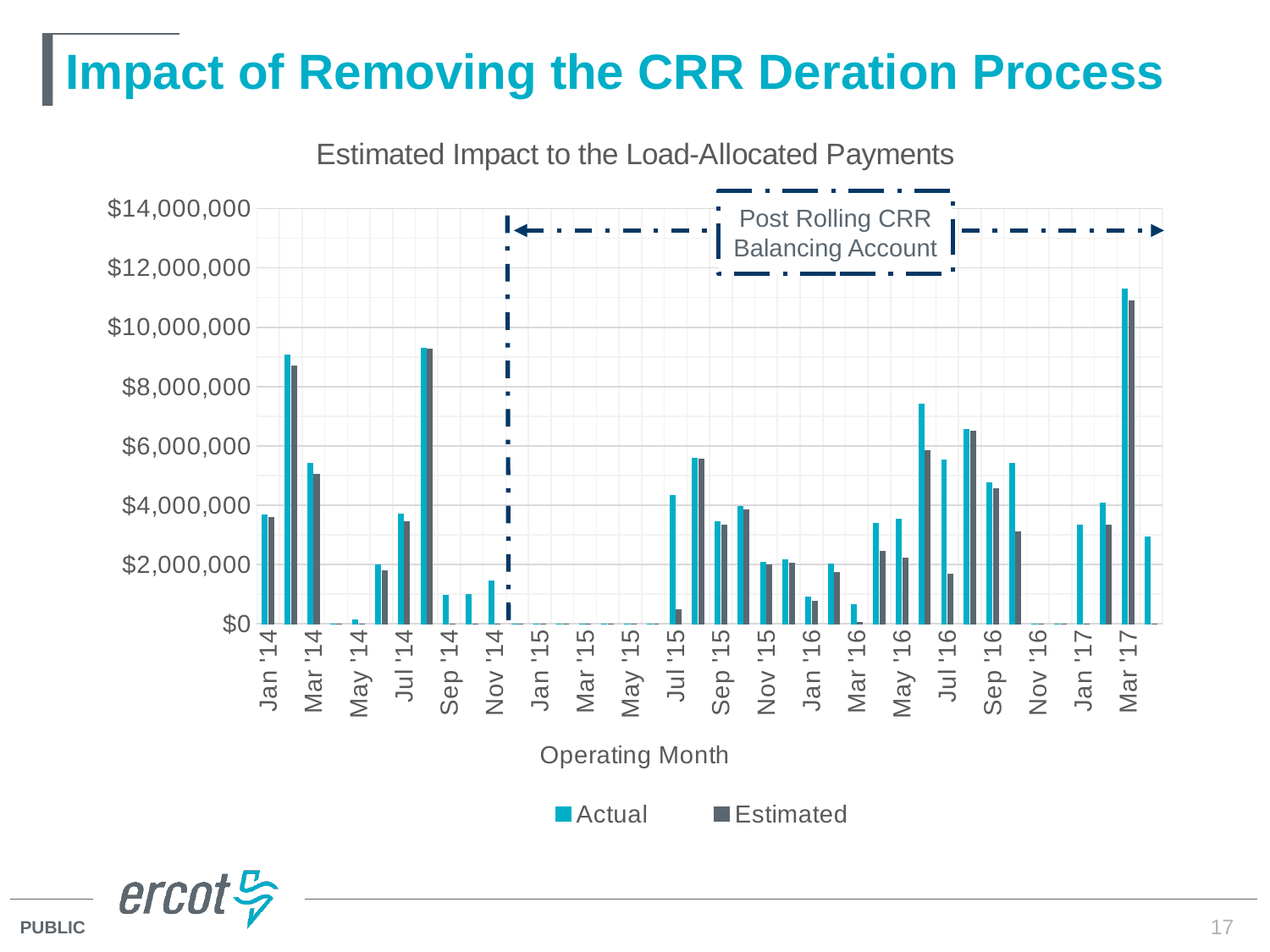
Which operating month has the highest Actual value? Mar '17 Is the Actual value for Jan '16 greater or less than $2,000,000? less Is the Actual value for Mar '17 greater or less than $10,000,000? greater Is the Actual value for Jan '14 greater or less than $4,000,000? less What is the title of the chart? Estimated Impact to the Load-Allocated Payments Which is larger for Jul '15, the Actual value or the Estimated value? Actual What kind of chart is shown on the slide? bar chart How many series does the legend list? 2 What are the two series named in the legend? Actual and Estimated